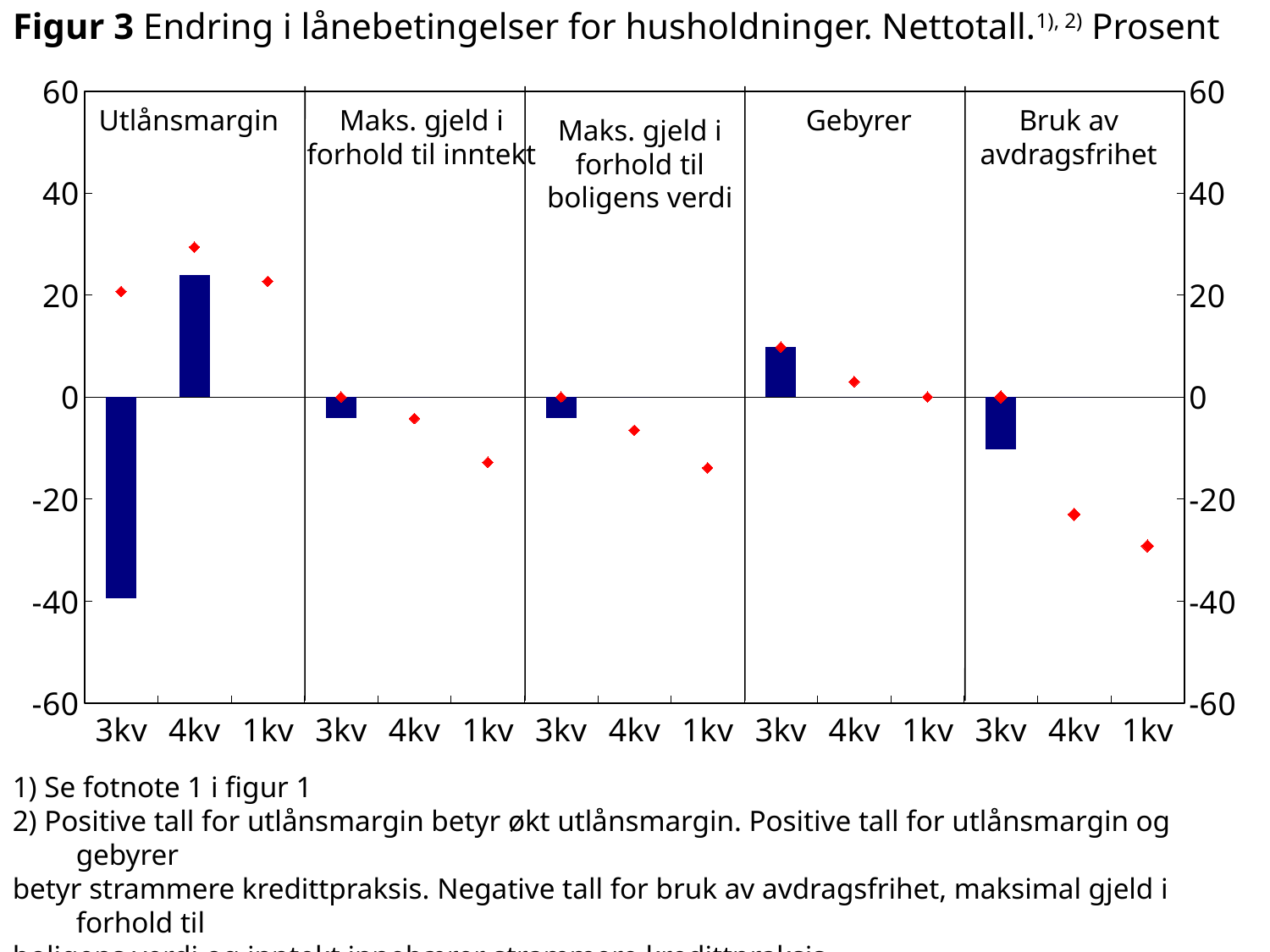
How many panels (lending condition categories) does the chart have? 5 Is the bar value for 4kv in the Utlånsmargin panel greater or less than 20? greater Do the red markers in the Bruk av avdragsfrihet panel rise or fall from 3kv to 1kv? fall Is the bar value for 3kv in the Bruk av avdragsfrihet panel greater or less than 0? less Which bar in the chart has the highest value? 4kv in Utlånsmargin Is the red marker for 1kv in the Bruk av avdragsfrihet panel greater or less than -20? less What kind of chart is shown on the slide? combination chart (bars with red diamond markers) Which bar in the chart has the lowest value? 3kv in Utlånsmargin How many quarters are shown on the x axis within each panel? 3